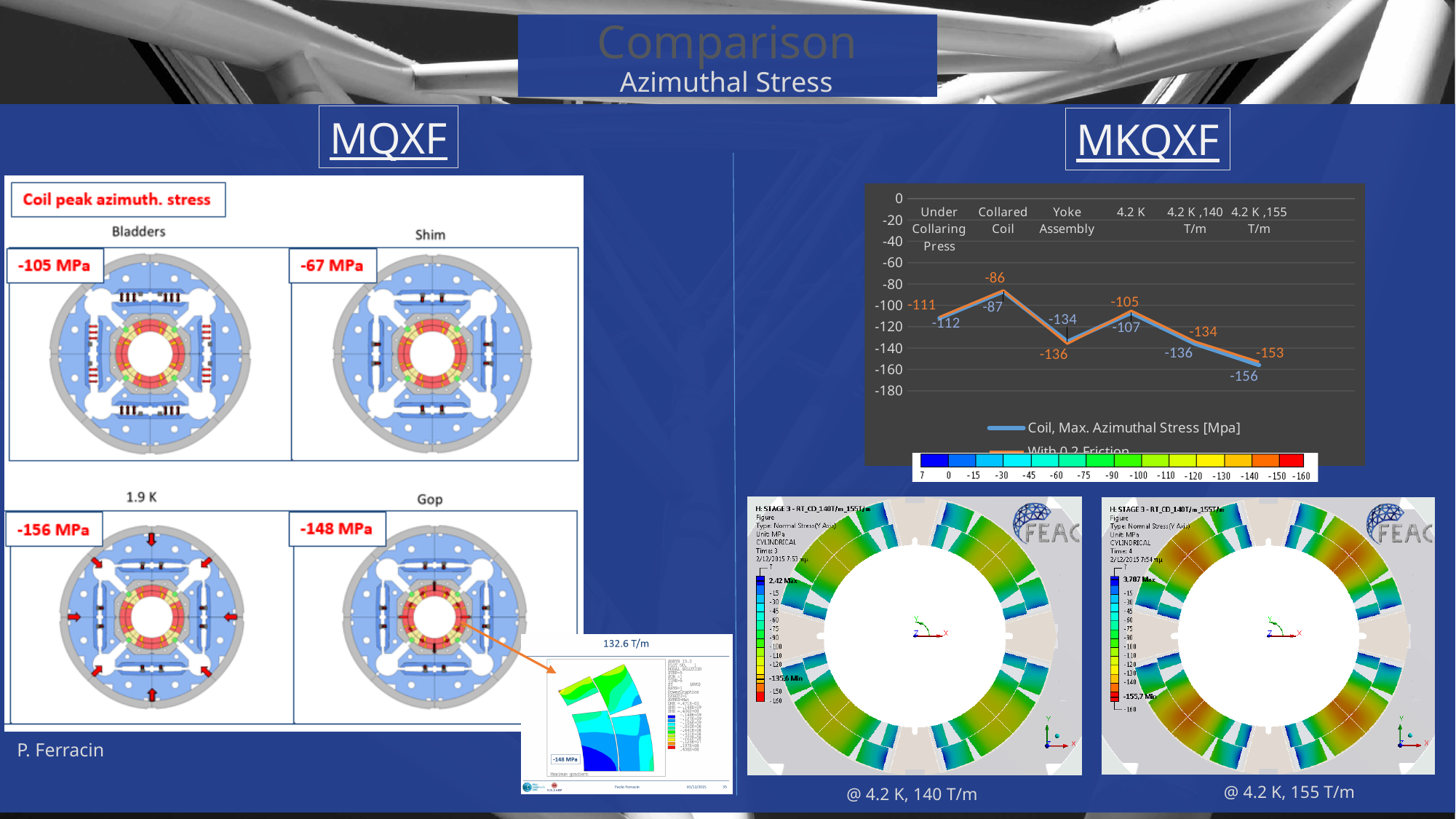
In the MKQXF chart, what is the difference between the 'Coil, Max. Azimuthal Stress [Mpa]' values at 'Under Collaring Press' (-112) and '4.2 K, 155 T/m' (-156)? 44 In the MKQXF chart, do the values of the 'Coil, Max. Azimuthal Stress [Mpa]' series rise or fall from '4.2 K' to '4.2 K, 155 T/m'? fall In the MKQXF chart, at 'Yoke Assembly', which series has the more negative value: 'Coil, Max. Azimuthal Stress [Mpa]' or 'With 0.2 Friction'? With 0.2 Friction In the MKQXF chart, what is the value of the 'Coil, Max. Azimuthal Stress [Mpa]' series at 'Collared Coil'? -87 How many categories are plotted along the x axis of the MKQXF chart? 6 In the MKQXF chart, at which category does the 'Coil, Max. Azimuthal Stress [Mpa]' series reach its lowest (most negative) value? 4.2 K, 155 T/m In the MKQXF chart, what is the value of the 'With 0.2 Friction' series at '4.2 K, 155 T/m'? -153 How many series does the legend of the MKQXF chart list? 2 In the MKQXF chart, what is the value of the 'Coil, Max. Azimuthal Stress [Mpa]' series at 'Under Collaring Press'? -112 What kind of chart is shown on the MKQXF side of the slide? line chart In the MKQXF chart, at which category does the 'With 0.2 Friction' series reach its highest (least negative) value? Collared Coil In the MKQXF chart, what is the value of the 'With 0.2 Friction' series at '4.2 K'? -105